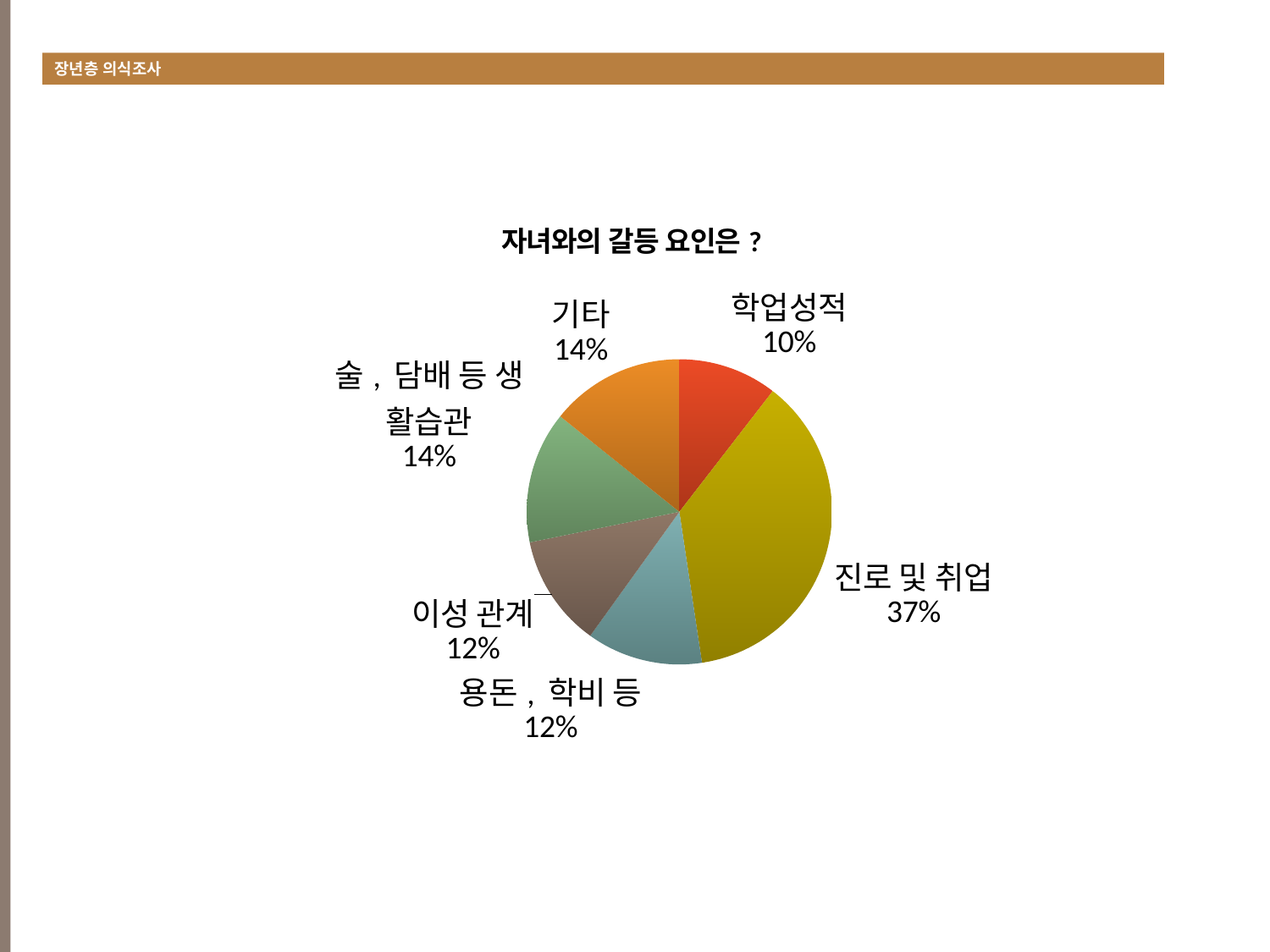
How many slices does the pie chart have? 6 Which category has the smallest share of the pie? 학업성적 What is the title of the chart? 자녀와의 갈등 요인은 ? What percentage is shown for 술, 담배 등 생활습관? 14% What is the difference in percentage points between 진로 및 취업 and 기타? 23 Which category has the largest share of the pie? 진로 및 취업 What kind of chart is shown on the slide? pie chart What percentage is shown for 이성 관계? 12% What is the combined share of 학업성적 and 진로 및 취업? 47% Which is larger, the share for 기타 or the share for 용돈, 학비 등? 기타 What percentage is shown for 학업성적? 10% What percentage is shown for 진로 및 취업? 37%